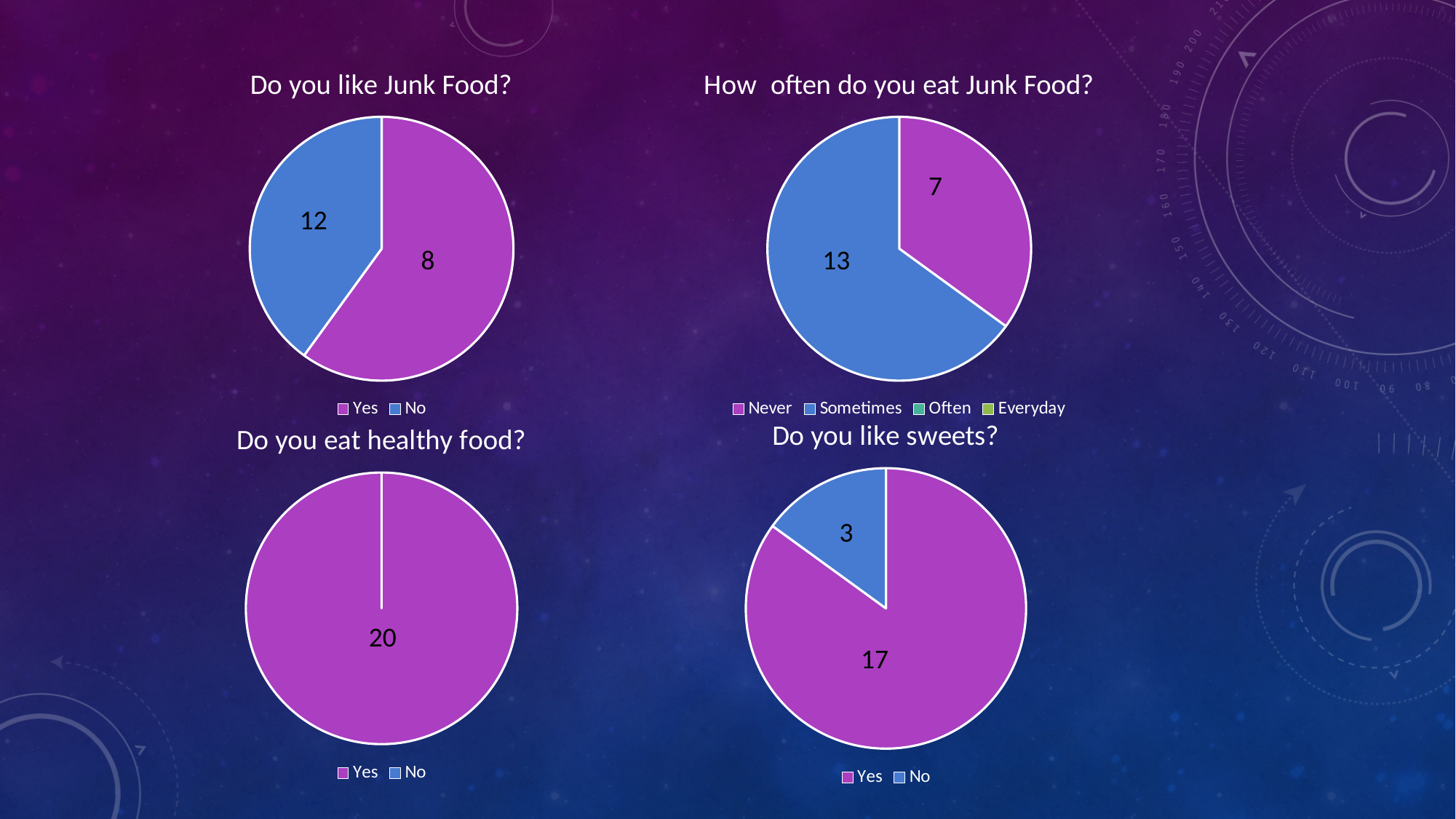
In the 'Do you like Junk Food?' chart, which category has the larger value, Yes or No? Yes In the 'Do you like Junk Food?' chart, what is the value for Yes? 12 In the 'Do you like Junk Food?' chart, what is the value for No? 8 In the 'Do you like sweets?' chart, what is the difference between Yes and No? 14 In the 'How often do you eat Junk Food?' chart, what is the value for Never? 7 In the 'Do you eat healthy food?' chart, what is the value for Yes? 20 In the 'Do you like sweets?' chart, what is the value for No? 3 How many entries does the legend of the 'How often do you eat Junk Food?' chart list? 4 In the 'How often do you eat Junk Food?' chart, what is the difference between Sometimes and Never? 6 In the 'Do you like sweets?' chart, what share of the pie does Yes represent? 85% What kind of chart is 'Do you eat healthy food?'? Pie chart In the 'How often do you eat Junk Food?' chart, what is the value for Sometimes? 13